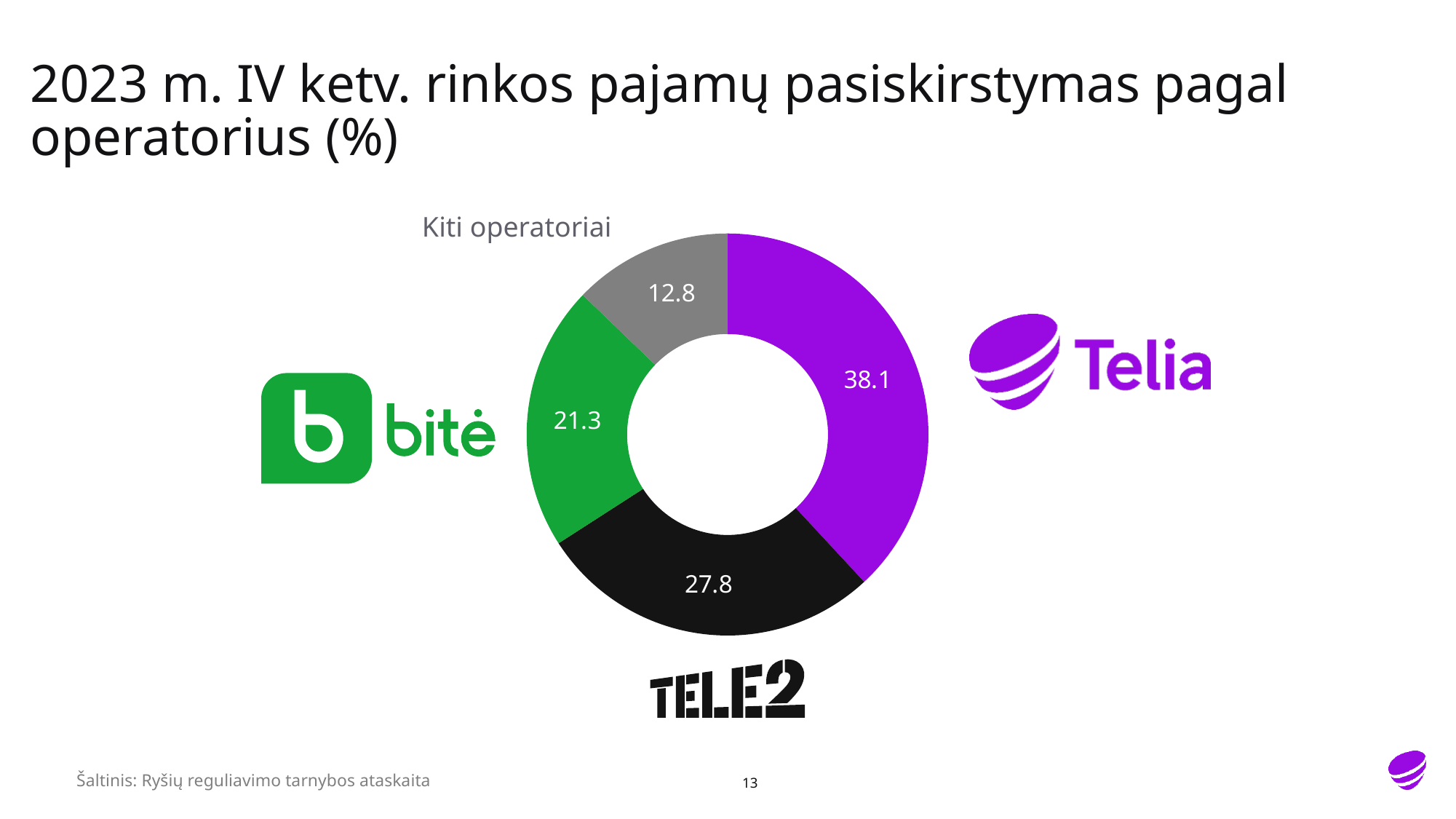
Which has a larger share, Tele2 or Bitė? Tele2 What value is shown for Bitė in the chart? 21.3 What type of chart is shown on the slide? Donut (pie) chart What colour is the Telia segment in the chart? Purple Which segment has the smallest share in the chart? Kiti operatoriai Which operator has the largest share in the chart? Telia What value is shown for 'Kiti operatoriai' in the chart? 12.8 What share of market revenue does Telia hold in the chart? 38.1 How many segments does the chart have? 4 What is the difference between Telia's share and Tele2's share? 10.3 What is the difference between Bitė's share and the share of 'Kiti operatoriai'? 8.5 What value is shown for Tele2 in the chart? 27.8